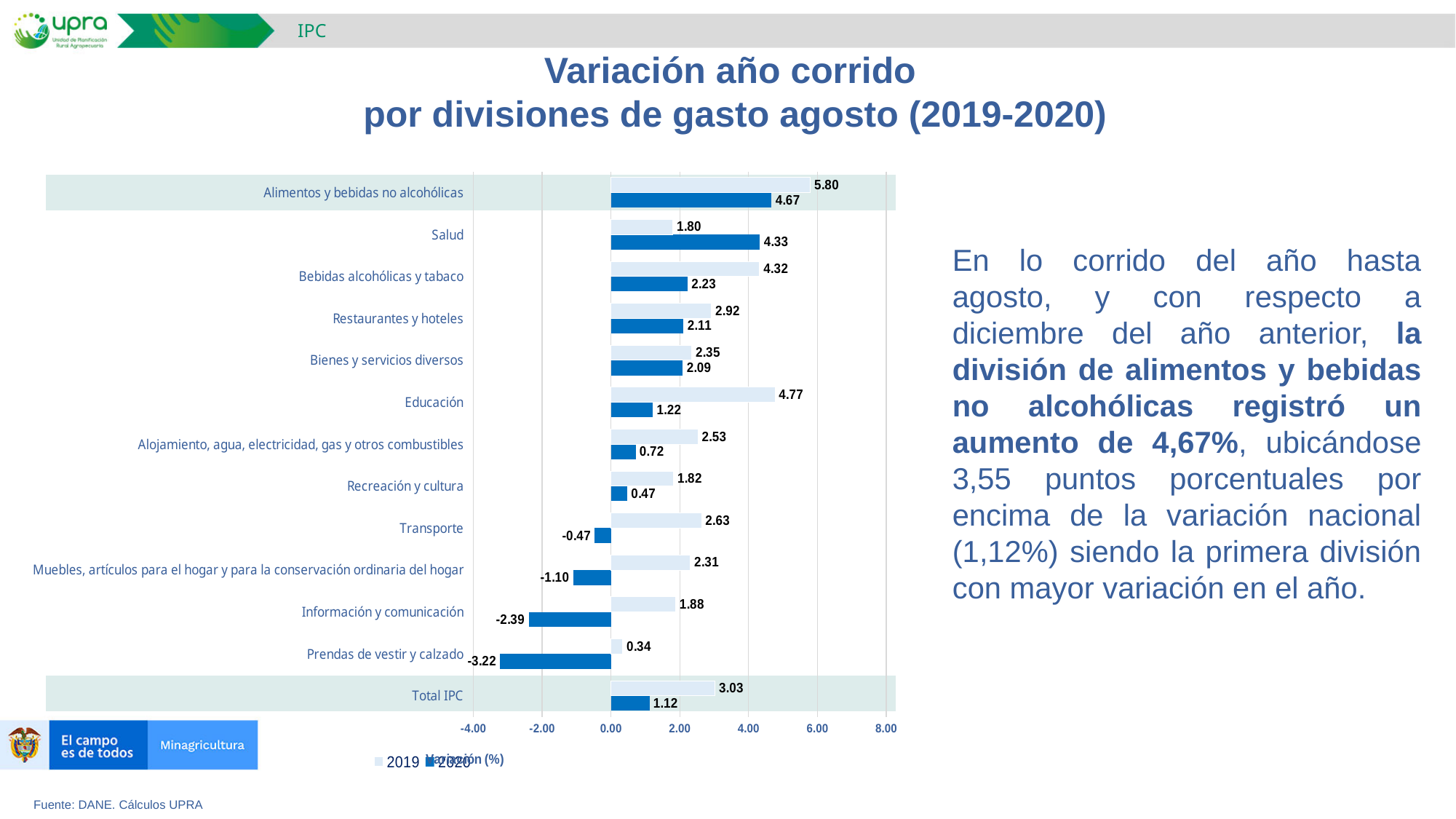
Which category has the lowest 2019 value? Prendas de vestir y calzado Which category has the lowest 2020 value? Prendas de vestir y calzado Which is larger for Educación, the 2019 value or the 2020 value? 2019 How many categories are shown on the chart, including Total IPC? 13 What is the 2019 value for Educación? 4.77 Which category has the highest 2020 value? Alimentos y bebidas no alcohólicas What is the 2020 value for Alimentos y bebidas no alcohólicas? 4.67 How many series does the legend list? 2 What is the 2020 value for Total IPC? 1.12 What is the 2020 value for Prendas de vestir y calzado? -3.22 What kind of chart is shown on the slide? Bar chart What is the difference between the 2019 and 2020 values for Salud? 2.53